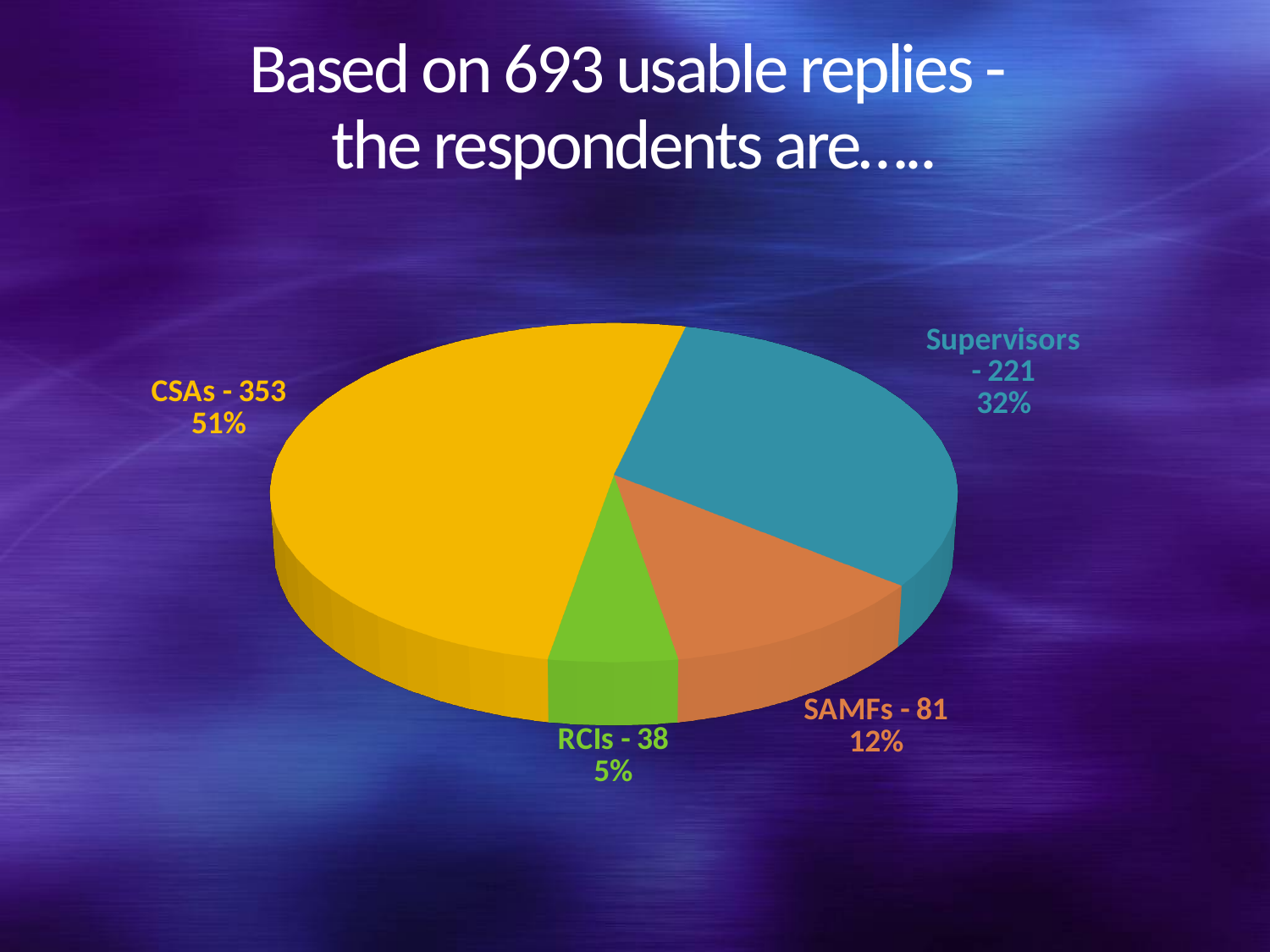
How many CSAs responded according to the pie chart? 353 How many categories does the pie chart show? 4 What colour is the slice representing Supervisors? Teal/blue What type of chart is shown on the slide? Pie chart What percentage of respondents are Supervisors? 32% Which category has the smallest slice of the pie? RCIs What is the difference in percentage points between SAMFs and RCIs? 7 What is the difference in count between CSAs and Supervisors? 132 What share of the pie do RCIs represent? 5% Which group has more respondents, SAMFs or RCIs? SAMFs Which category has the largest slice of the pie? CSAs How many SAMFs are shown in the pie chart? 81